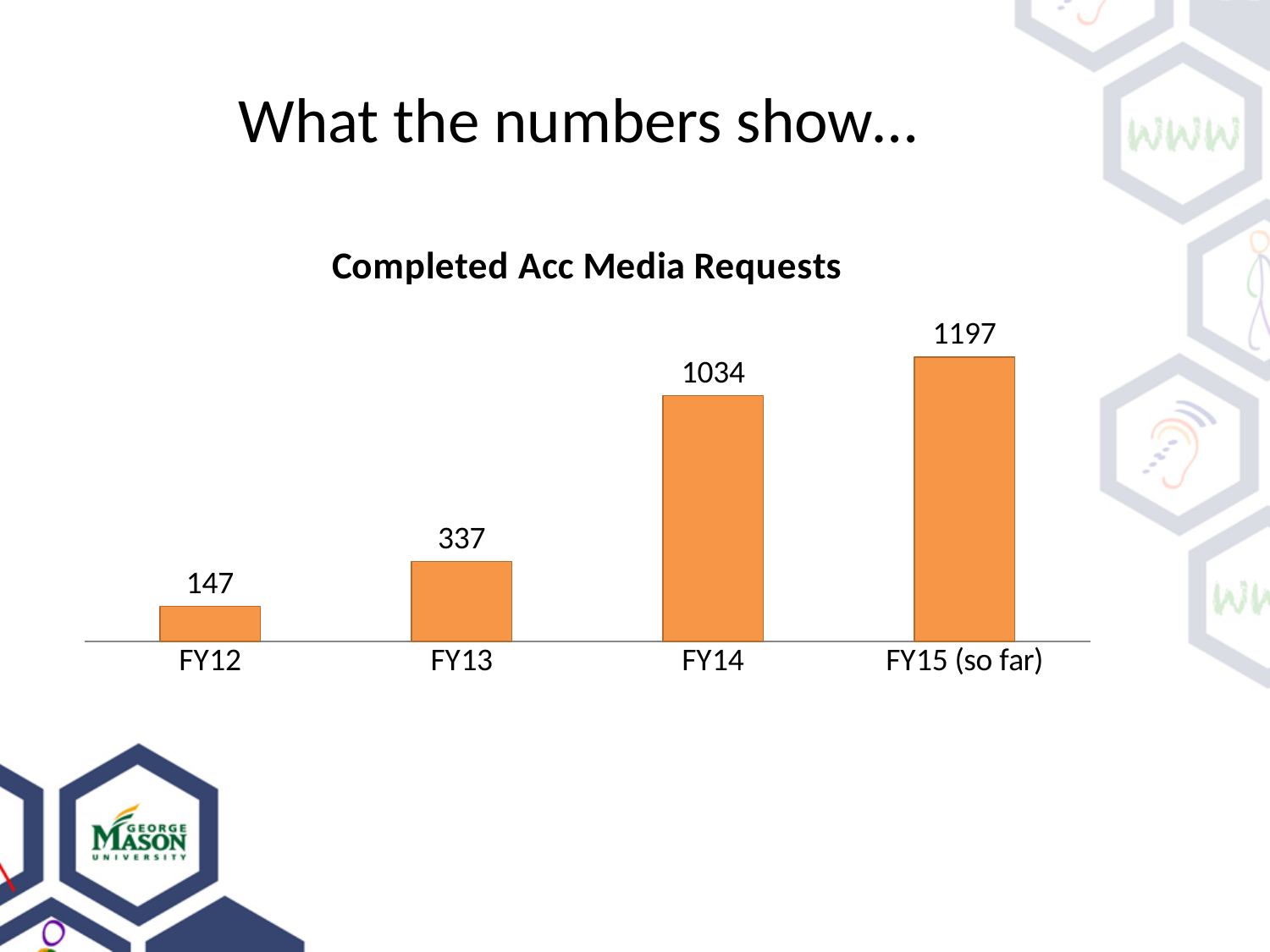
What kind of chart is this? bar chart What is the difference between the values for FY14 and FY13? 697 What is the difference between the values for FY15 (so far) and FY14? 163 Which category has the highest value? FY15 (so far) Which category has the lowest value? FY12 What is the value for FY15 (so far)? 1197 Which is larger, the value for FY13 or the value for FY12? FY13 What is the value for FY12? 147 How many categories are shown on the x axis? 4 Do the values rise or fall from FY12 to FY15 (so far)? rise What is the value for FY14? 1034 What is the value for FY13? 337